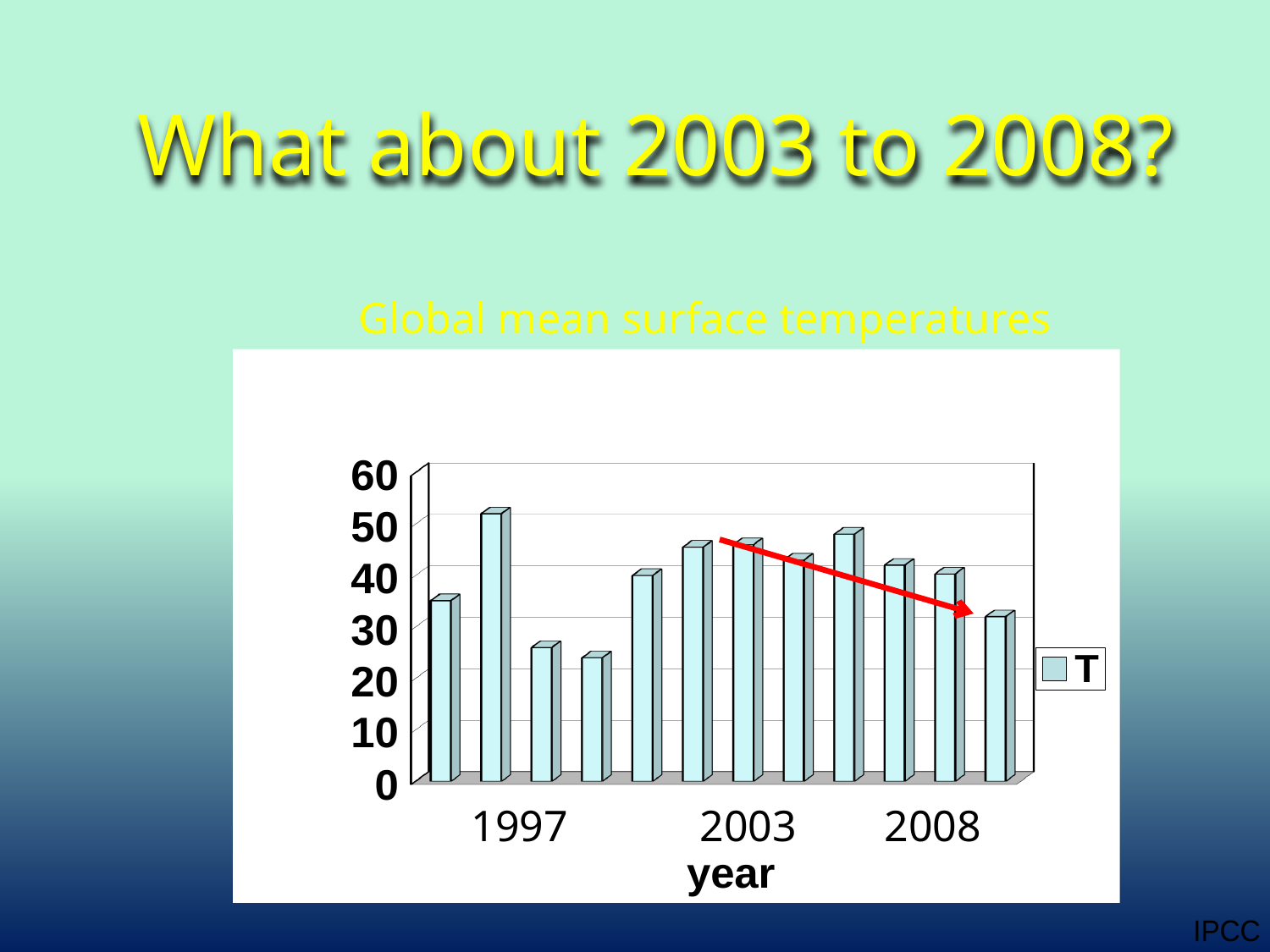
How many bars are plotted in the chart? 12 Is the value for 2003 greater or less than 40? greater Which of the labelled years, 1997 or 2008, has the higher value? 1997 Do the values rise or fall from 2003 to 2008? fall Is the value for 1997 greater or less than 40? less Is the value for 2008 greater or less than 50? less How many series does the chart legend list? 1 What is the name of the series shown in the chart legend? T What is the title of the chart? Global mean surface temperatures Which of the labelled years, 2003 or 2008, has the higher value? 2003 What kind of chart is shown on the slide? bar chart Which labelled year has the highest bar in the chart? 2003